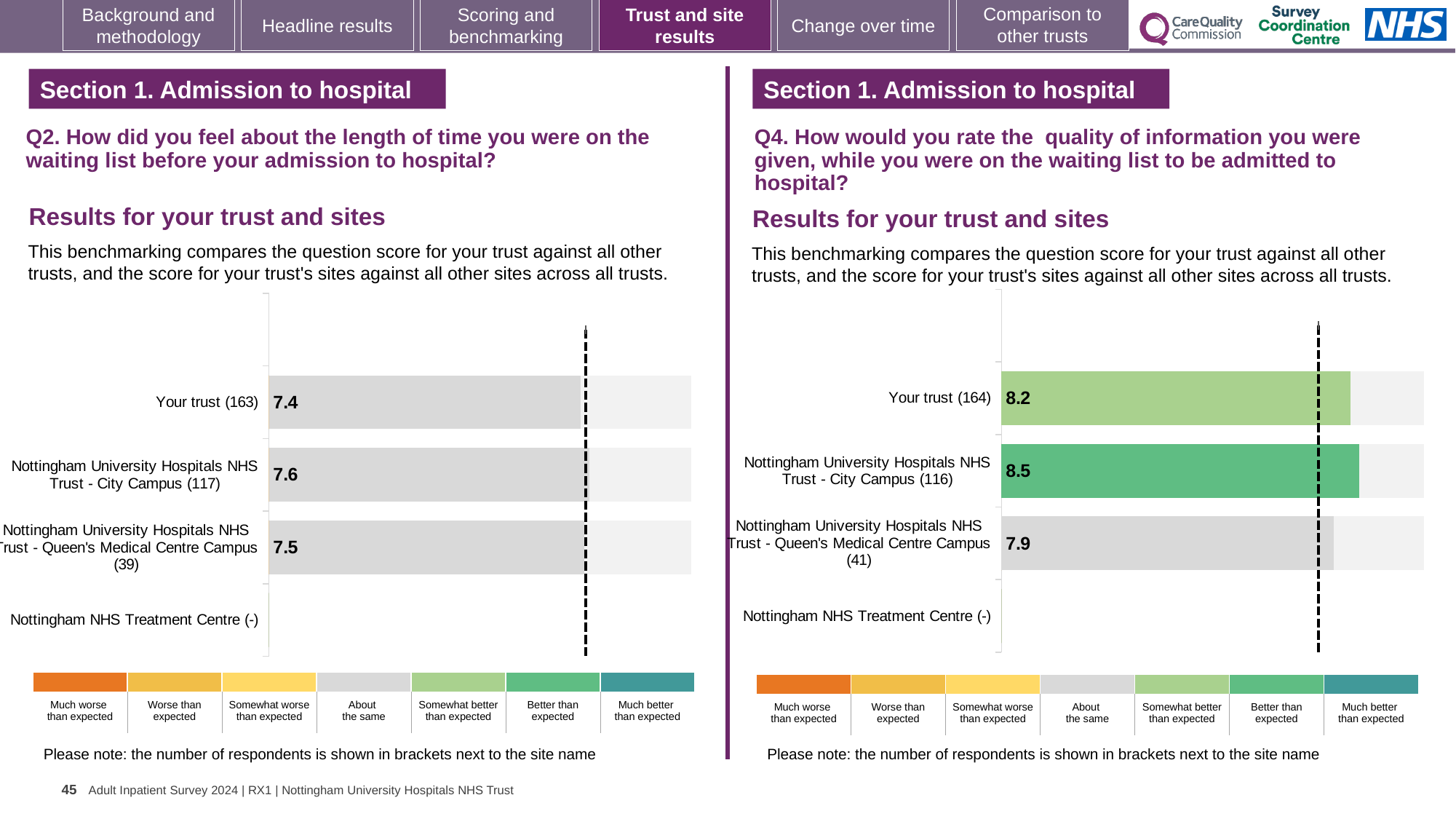
In the Q2 chart on the left, what is the score for Your trust (163)? 7.4 In the Q4 chart on the right, which site has the highest score? Nottingham University Hospitals NHS Trust - City Campus (116) In the Q2 chart on the left, what is the difference between the City Campus score and the Your trust score? 0.2 What type of chart is used in the Q2 chart on the left? Bar chart How many site categories are listed on the y axis of the Q4 chart on the right? 4 In the Q4 chart on the right, what is the score for Nottingham University Hospitals NHS Trust - Queen's Medical Centre Campus (41)? 7.9 In the Q4 chart on the right, which has the lower score: Your trust (164) or Queen's Medical Centre Campus (41)? Queen's Medical Centre Campus (41) In the Q2 chart on the left, which site has the highest score? Nottingham University Hospitals NHS Trust - City Campus (117) In the Q4 chart on the right, what is the difference between the City Campus score and the Queen's Medical Centre Campus score? 0.6 In the Q2 chart on the left, what is the score for Nottingham University Hospitals NHS Trust - City Campus (117)? 7.6 In the Q4 chart on the right, what is the score for Your trust (164)? 8.2 In the Q4 chart on the right, which benchmark category does the colour of the City Campus bar correspond to in the legend? Better than expected